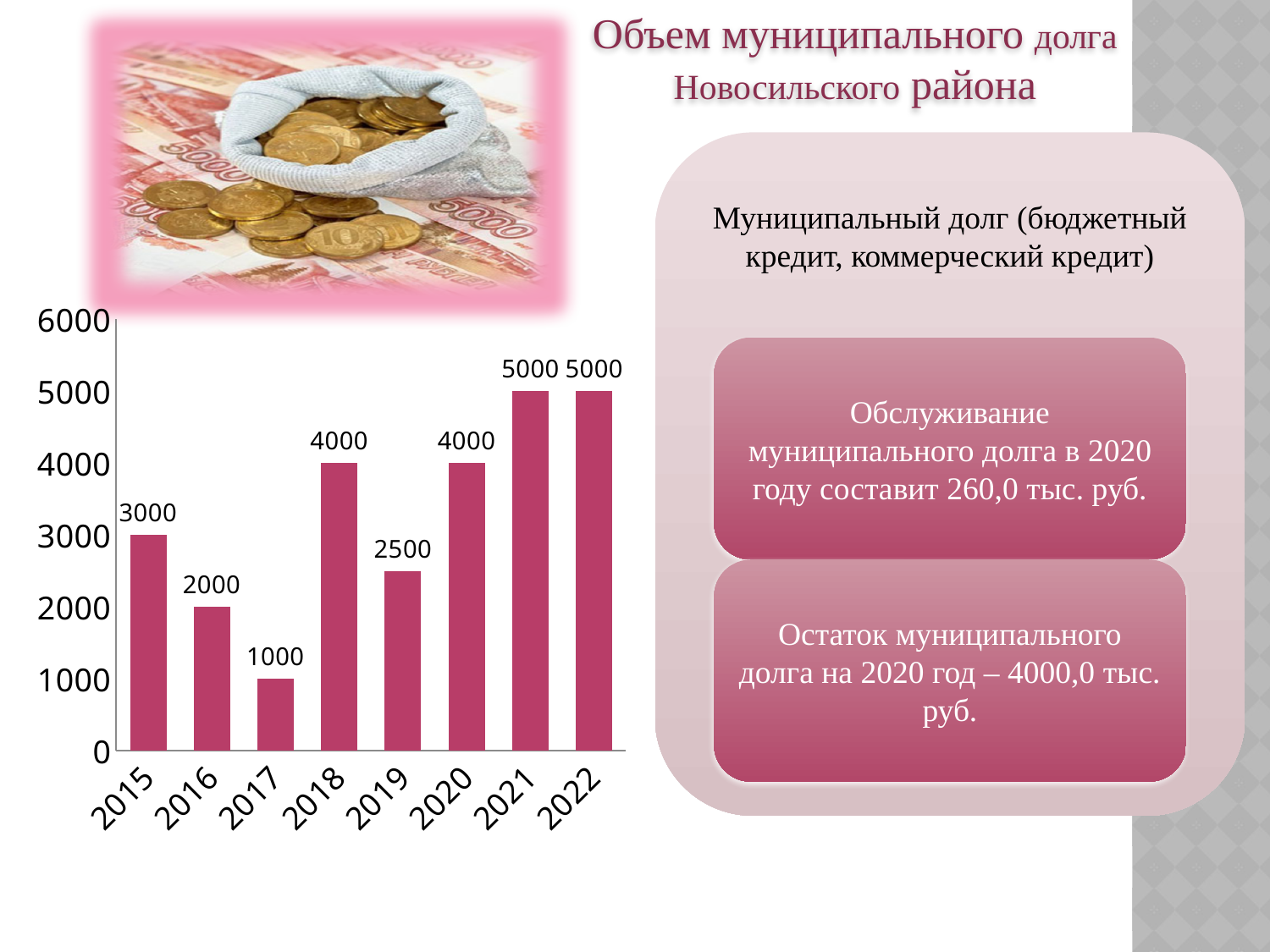
What is the difference between the values for 2021 and 2015? 2000 Do the values rise or fall from 2015 to 2017? fall What kind of chart is shown on the slide? bar chart What is the difference between the values for 2018 and 2019? 1500 Do the values rise or fall from 2019 to 2021? rise Which is larger, the value for 2016 or the value for 2020? 2020 How many years are shown on the x axis? 8 What is the value for 2015? 3000 Which year has the lowest value? 2017 What is the value for 2017? 1000 What is the value for 2019? 2500 What is the highest value shown on the vertical axis? 6000